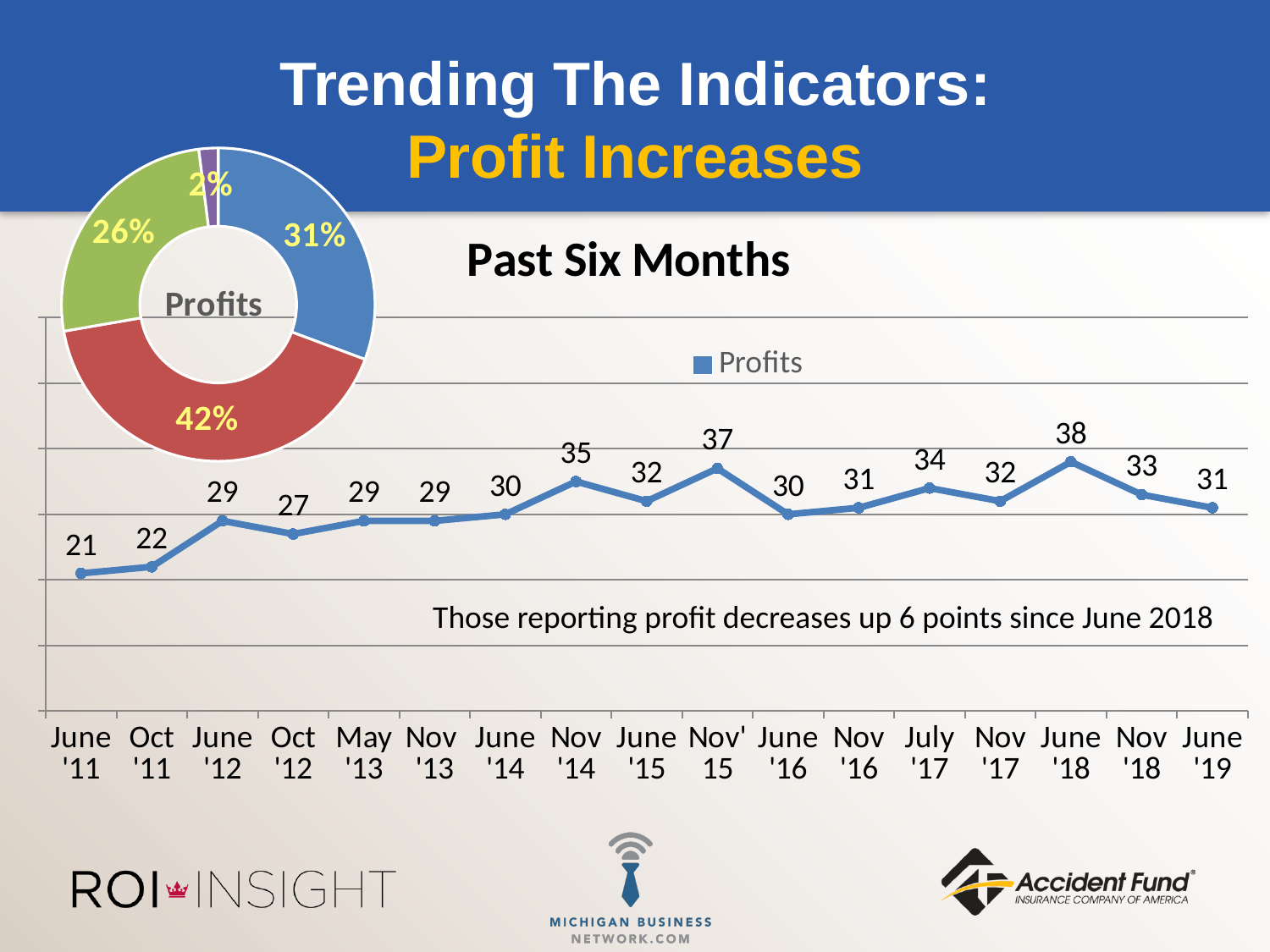
In the line chart titled 'Past Six Months', which period has the highest value? June '18 In the line chart titled 'Past Six Months', how many series does the legend list? 1 In the line chart titled 'Past Six Months', how many data points are plotted? 17 In the donut chart titled 'Profits' at the top left, how many slices are there? 4 In the line chart titled 'Past Six Months', what is the value for June '19? 31 In the line chart titled 'Past Six Months', what is the difference between the values for June '18 and June '19? 7 In the line chart titled 'Past Six Months', what is the value for Nov '14? 35 In the line chart titled 'Past Six Months', do the values rise or fall from June '11 to June '12? rise What kind of chart is the chart titled 'Past Six Months'? line chart In the donut chart titled 'Profits' at the top left, what is the largest slice's percentage? 42% In the line chart titled 'Past Six Months', which is larger, the value for Nov' 15 or the value for June '16? Nov' 15 In the line chart titled 'Past Six Months', which period has the lowest value? June '11